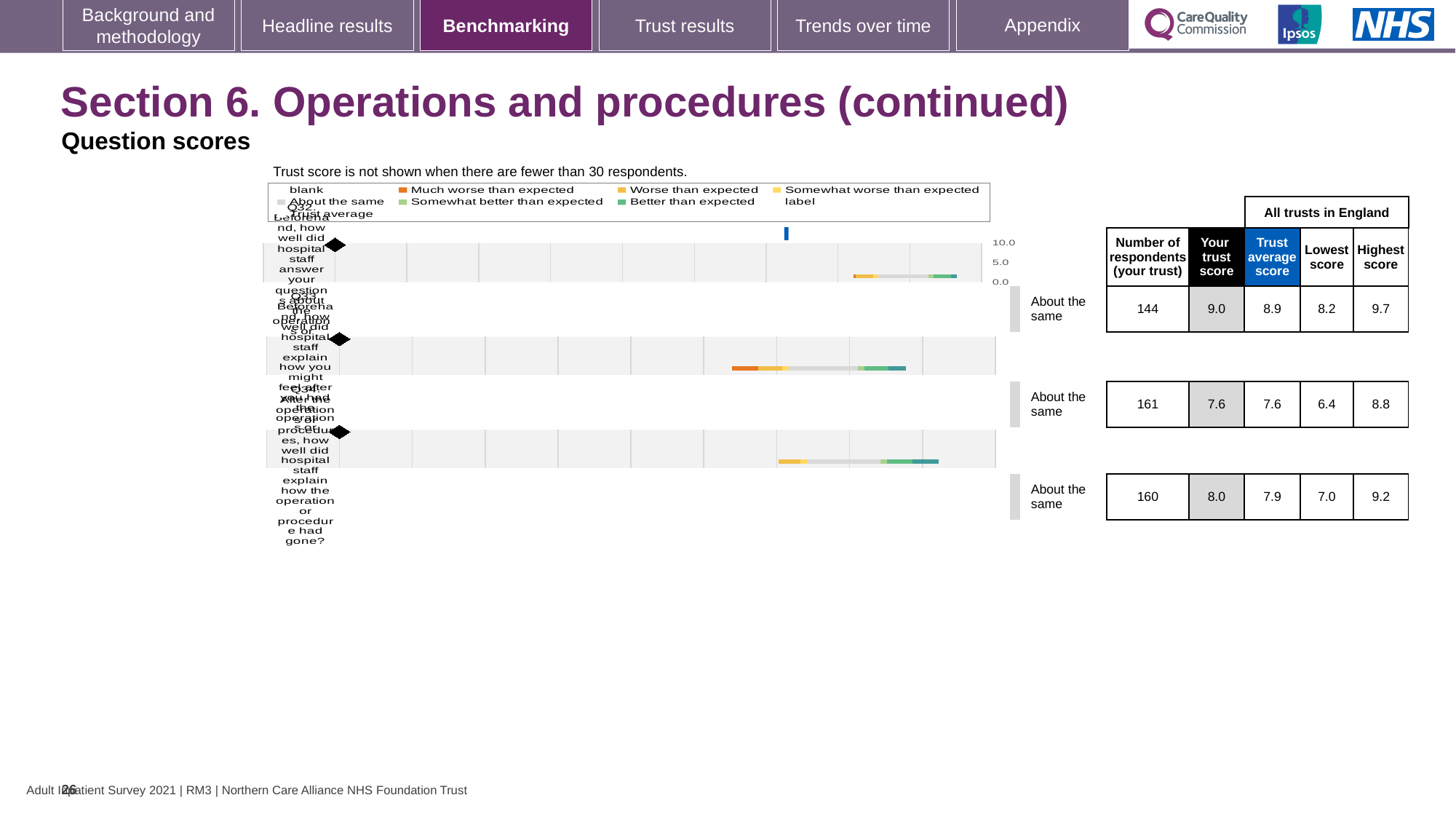
Which of the three charts has the highest 'Your trust score'? The top chart (9.0) On the top chart, what is the difference between the highest score and the lowest score? 1.5 Which of the three charts has the lowest 'Lowest score' value? The middle chart (6.4) On the bottom chart, which is larger: your trust score or the trust average score? Your trust score (8.0) What benchmark category label is shown beside each of the three charts? About the same What kind of chart is used for each question on the slide? Bar chart On the top chart, is your trust score greater or less than 5.0? greater On the middle chart, what is the trust average score for all trusts in England? 7.6 On the top chart, what is the 'Your trust score' value? 9.0 On the bottom chart, what is the highest score among all trusts in England? 9.2 On the top chart, how many respondents does the table show for your trust? 144 How many question charts are shown on the slide? 3